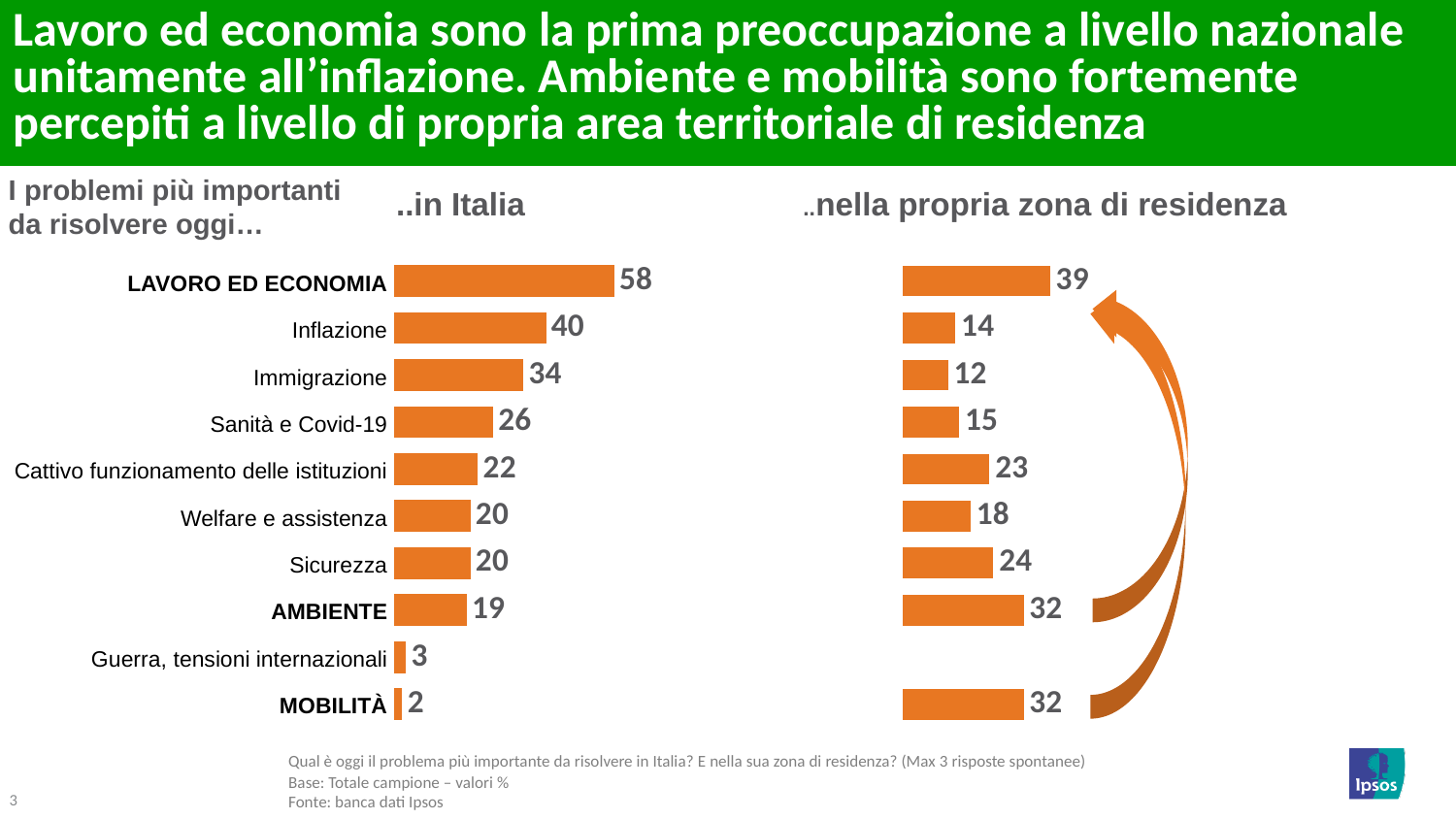
In the "..in Italia" chart, what is the difference between Inflazione and Immigrazione? 6 In the "..nella propria zona di residenza" chart, what is the value for Sicurezza? 24 In the "..nella propria zona di residenza" chart, what is the value for Ambiente? 32 In the "..nella propria zona di residenza" chart, which category has the highest value? Lavoro ed economia In the "..in Italia" chart, which category has the lowest value? Mobilità In the "..in Italia" chart, which category has the highest value? Lavoro ed economia Is the value for Mobilità larger in the "..in Italia" chart or in the "..nella propria zona di residenza" chart? ..nella propria zona di residenza In the "..nella propria zona di residenza" chart, which is larger: Cattivo funzionamento delle istituzioni or Welfare e assistenza? Cattivo funzionamento delle istituzioni What is the difference between the value for Lavoro ed economia in the "..in Italia" chart and in the "..nella propria zona di residenza" chart? 19 What type of chart is the "..in Italia" chart? Bar chart In the "..in Italia" chart, what is the value for Inflazione? 40 How many categories are listed in the "..in Italia" chart? 10